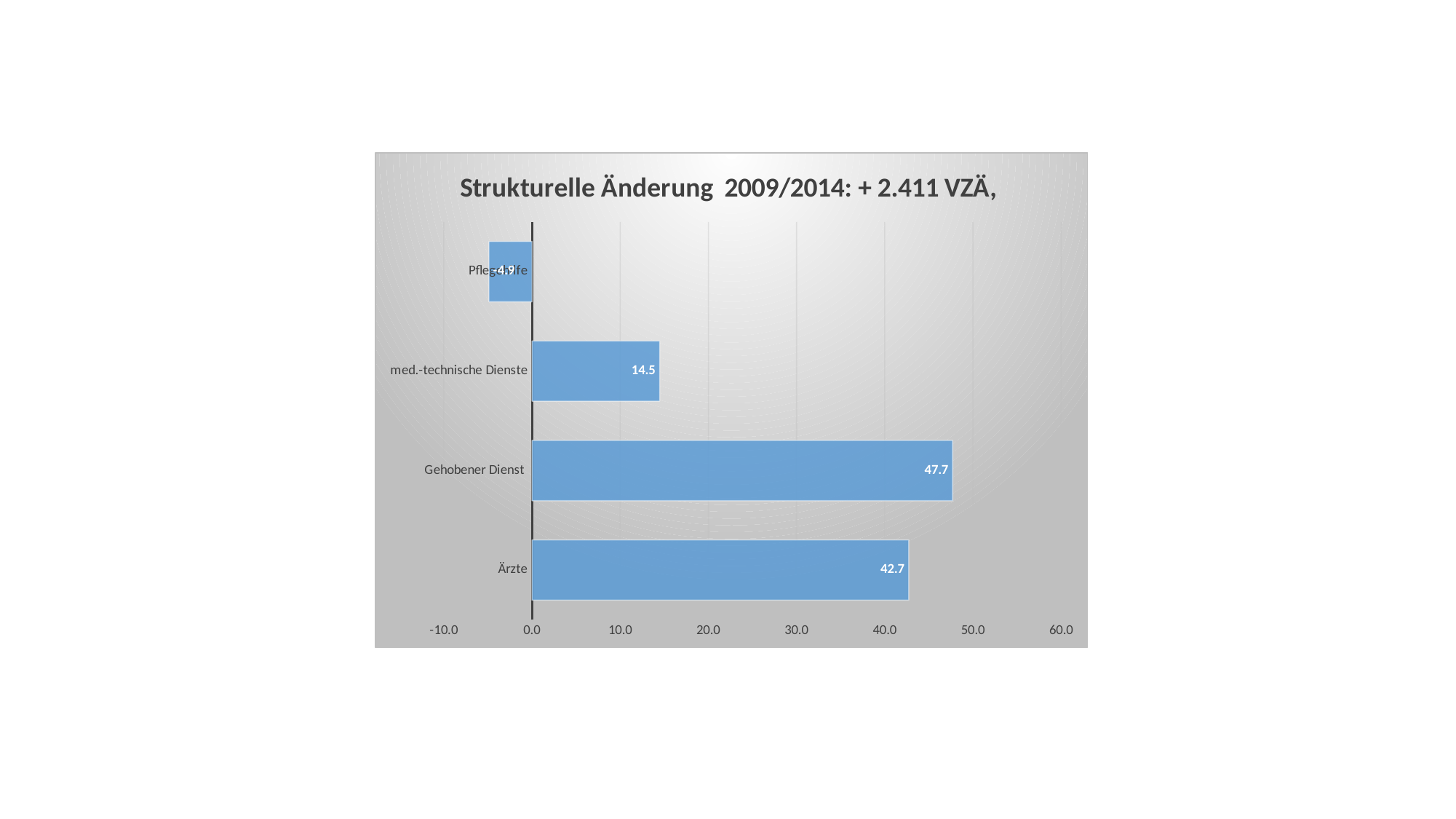
Which is larger, the value for Ärzte or the value for med.-technische Dienste? Ärzte What kind of chart is shown on the slide? bar chart What is the difference between the values for Gehobener Dienst and Ärzte? 5.0 What is the value for Gehobener Dienst? 47.7 Which category has the highest value? Gehobener Dienst What is the difference between the values for Gehobener Dienst and med.-technische Dienste? 33.2 Is the value for the topmost bar in the chart greater or less than 0.0? less How many categories are shown in the chart? 4 Is the value for Ärzte greater or less than 40.0? greater What is the value for med.-technische Dienste? 14.5 What is the value for Ärzte? 42.7 What is the title of the chart? Strukturelle Änderung 2009/2014: + 2.411 VZÄ,